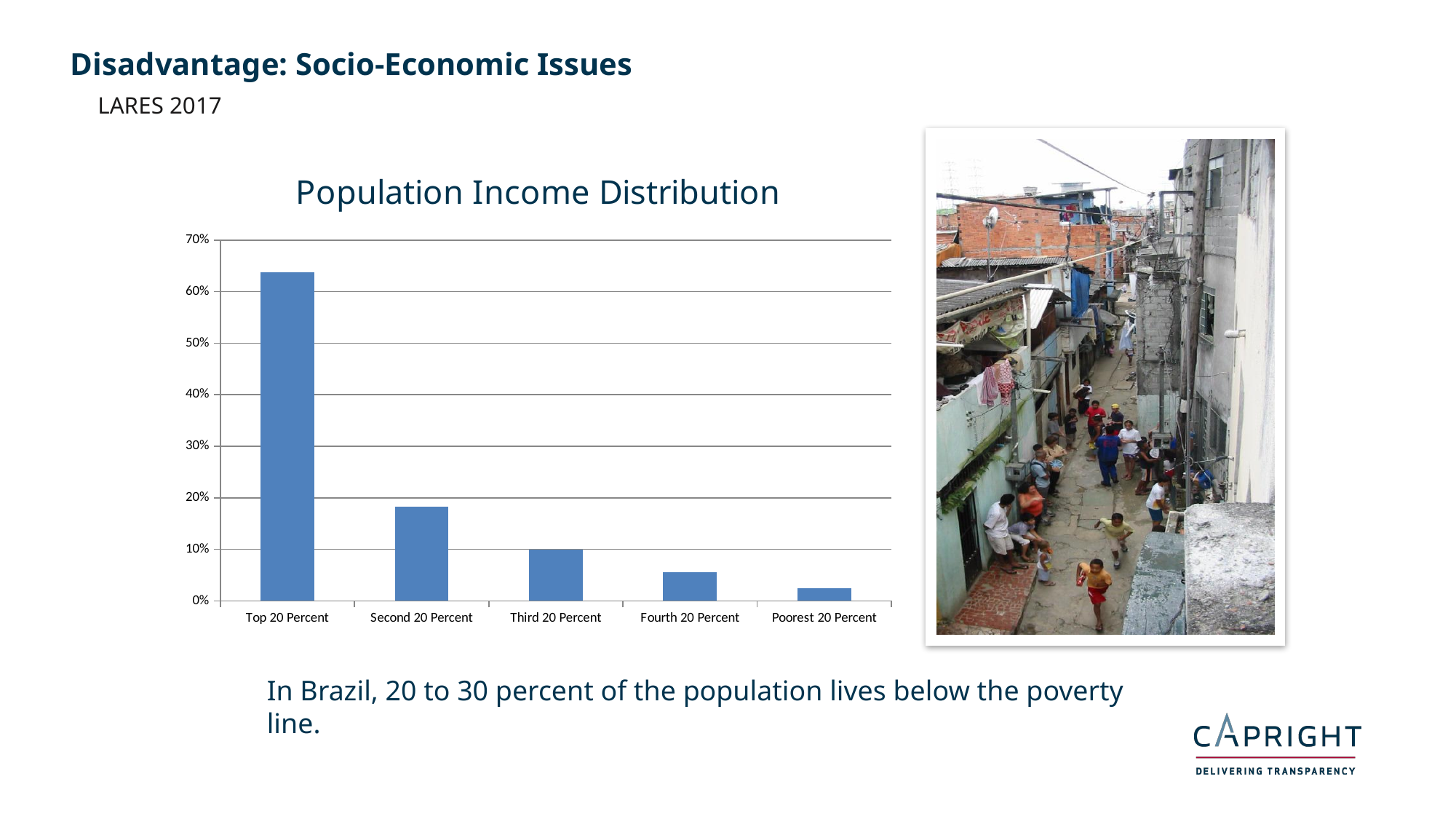
How many categories are shown on the x axis of the chart? 5 Is the value for Poorest 20 Percent greater or less than 10%? less Is the value for Top 20 Percent greater or less than 60%? greater Do the values rise or fall moving from Top 20 Percent to Poorest 20 Percent along the x axis? fall Which category has the highest value in the chart? Top 20 Percent Which is larger, the value for Second 20 Percent or the value for Third 20 Percent? Second 20 Percent What is the highest value shown on the y axis of the chart? 70% Is the value for Second 20 Percent greater or less than 20%? less Which category has the lowest value in the chart? Poorest 20 Percent What type of chart is shown under the title "Population Income Distribution"? bar chart What is the title of the chart? Population Income Distribution